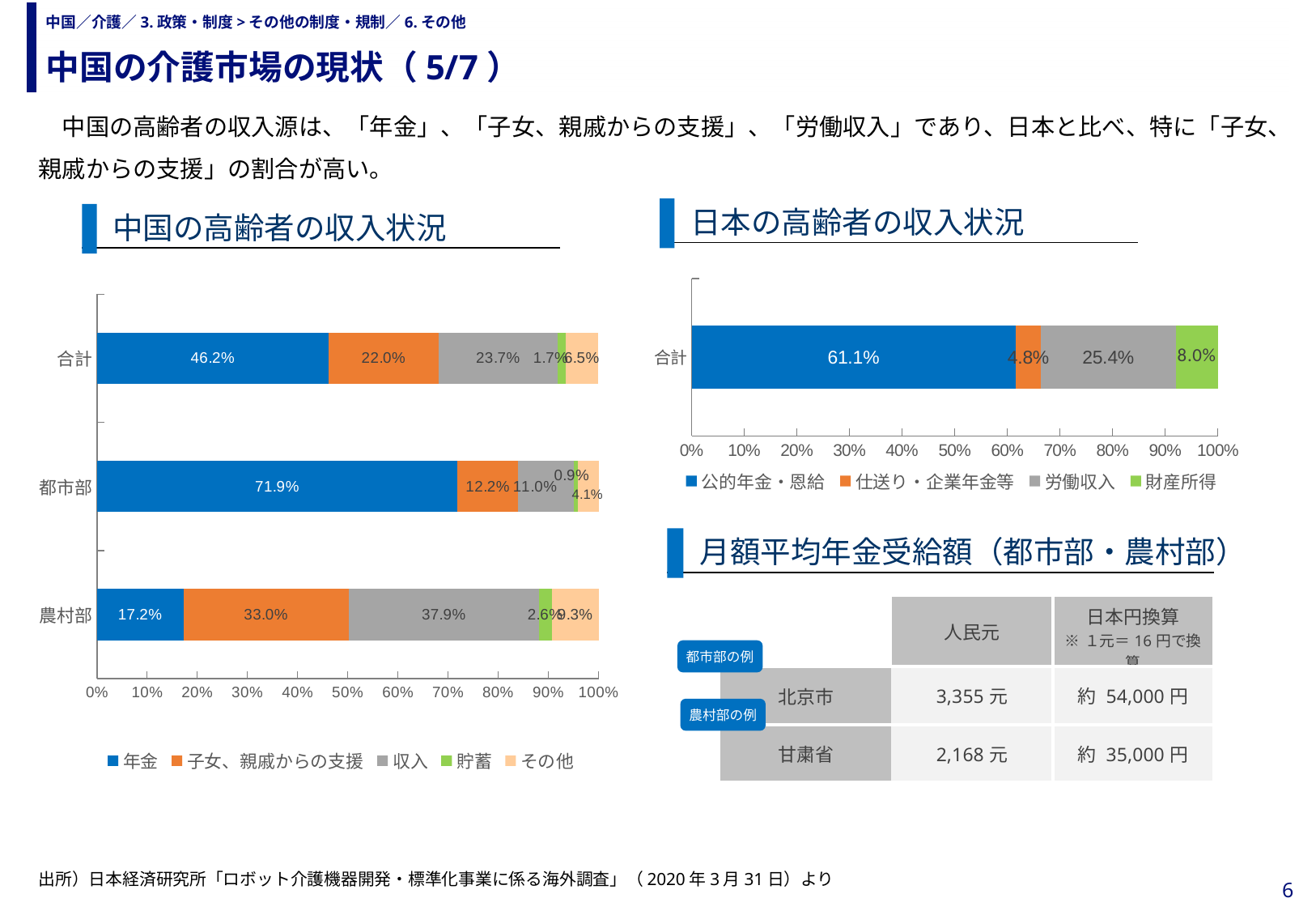
In the chart titled 中国の高齢者の収入状況, what is the value of 年金 for 都市部? 71.9% In the chart titled 中国の高齢者の収入状況, which category has the lowest 年金 share? 農村部 In the chart titled 中国の高齢者の収入状況, what is the value of 収入 for 合計? 23.7% In the chart titled 日本の高齢者の収入状況, what is the value of 労働収入? 25.4% How many series does the legend of the chart titled 日本の高齢者の収入状況 list? 4 In the chart titled 中国の高齢者の収入状況, which category has the highest 年金 share? 都市部 In the chart titled 中国の高齢者の収入状況, for 農村部, which is larger: 子女、親戚からの支援 or 収入? 収入 In the chart titled 日本の高齢者の収入状況, what is the difference between 公的年金・恩給 and 労働収入? 35.7 percentage points How many categories are shown on the y axis of the chart titled 中国の高齢者の収入状況? 3 In the chart titled 中国の高齢者の収入状況, what is the difference between the 年金 share for 都市部 and for 農村部? 54.7 percentage points In the chart titled 中国の高齢者の収入状況, what is the value of 子女、親戚からの支援 for 農村部? 33.0% In the chart titled 日本の高齢者の収入状況, what is the value of 公的年金・恩給? 61.1%